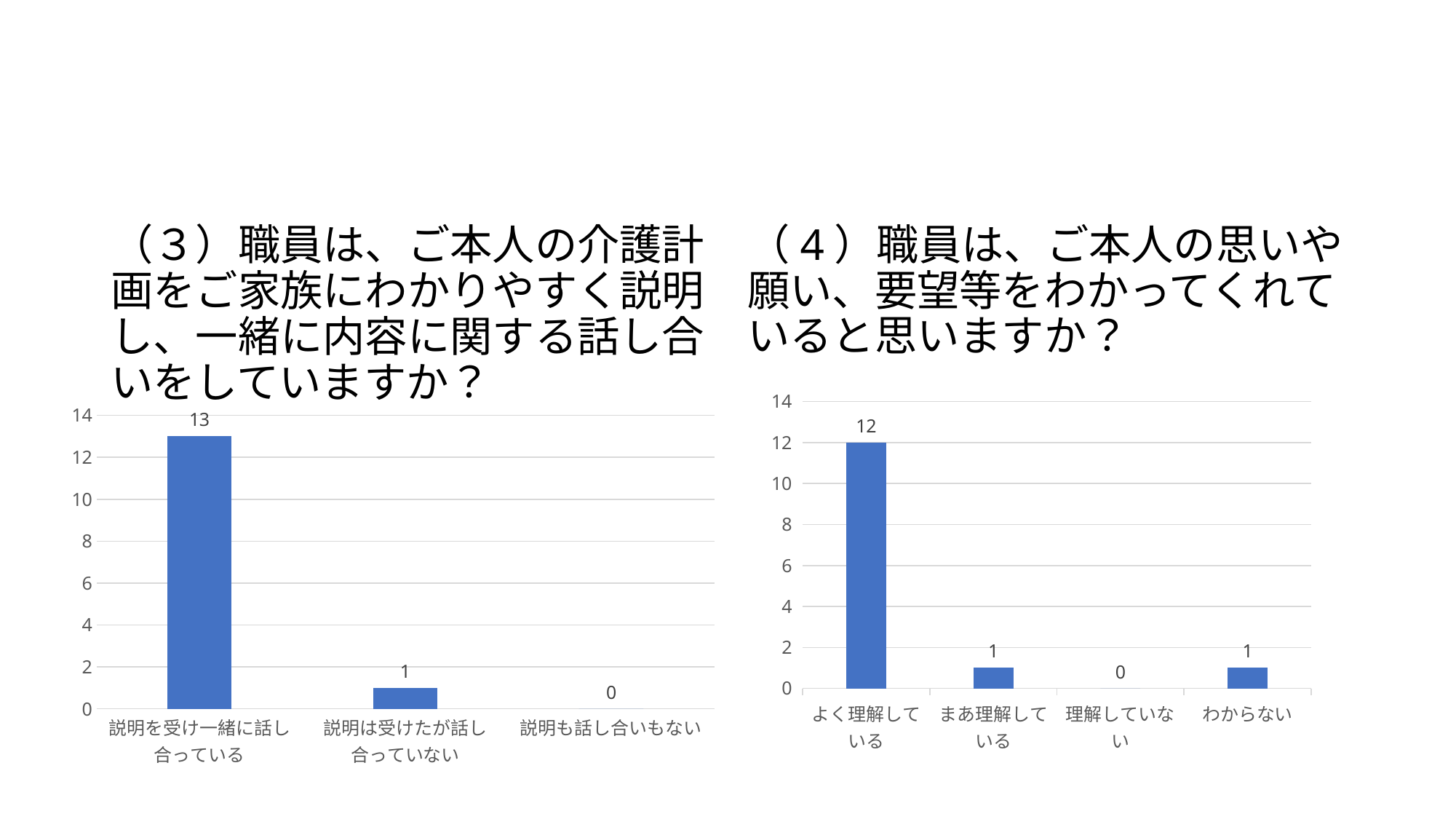
In the left chart (3), what is the value for 説明は受けたが話し合っていない? 1 In the left chart (3), what is the value for 説明を受け一緒に話し合っている? 13 What kind of chart is the right chart (4)? bar chart In the right chart (4), what is the value for 理解していない? 0 In the right chart (4), how many categories are shown on the x axis? 4 In the left chart (3), what is the difference between 説明を受け一緒に話し合っている and 説明は受けたが話し合っていない? 12 In the right chart (4), what is the difference between よく理解している and わからない? 11 In the right chart (4), which category has the lowest value? 理解していない In the right chart (4), what is the value for よく理解している? 12 In the left chart (3), what is the value for 説明も話し合いもない? 0 In the left chart (3), which category has the highest value? 説明を受け一緒に話し合っている In the left chart (3), how many categories are shown on the x axis? 3